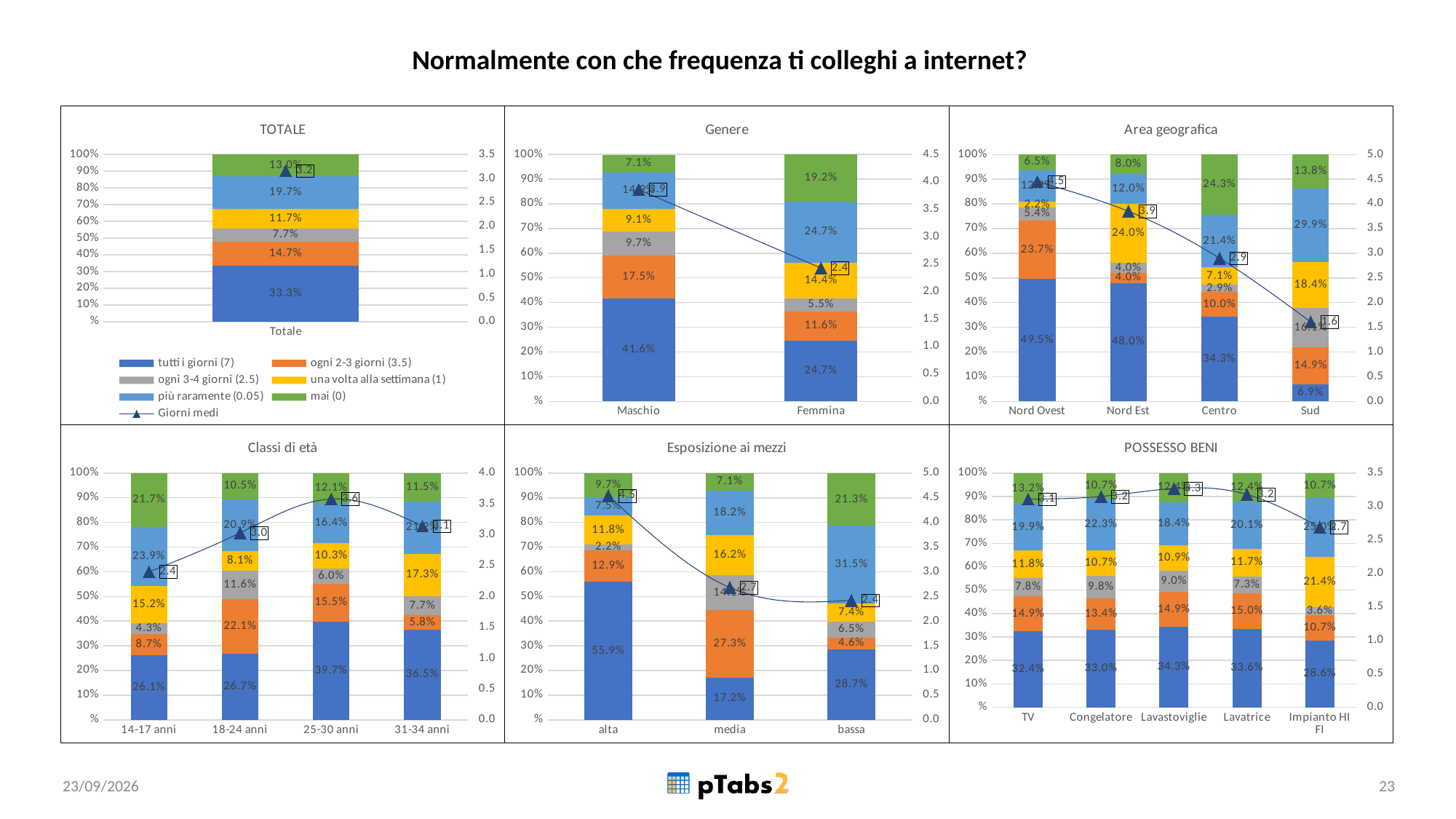
How many series does the legend in the TOTALE chart list? 7 In the TOTALE chart, what percentage of the Totale bar is 'tutti i giorni (7)'? 33.3% In the Area geografica chart, what is the 'mai (0)' share for Centro? 24.3% In the POSSESSO BENI chart, what is the Giorni medi value for Impianto HI FI? 2.7 In the Classi di età chart, which age class has the highest Giorni medi value? 25-30 anni In the Esposizione ai mezzi chart, what is the difference between the 'tutti i giorni (7)' share for alta and for media? 38.7% In the Genere chart, what is the 'tutti i giorni (7)' share for Maschio? 41.6% In the Classi di età chart, how many age categories are shown on the x axis? 4 In the Genere chart, which category has the higher Giorni medi value, Maschio or Femmina? Maschio In the Area geografica chart, which area has the lowest Giorni medi value? Sud In the TOTALE chart, what is the Giorni medi value for Totale? 3.2 In the Esposizione ai mezzi chart, what is the 'più raramente (0.05)' share for bassa? 31.5%